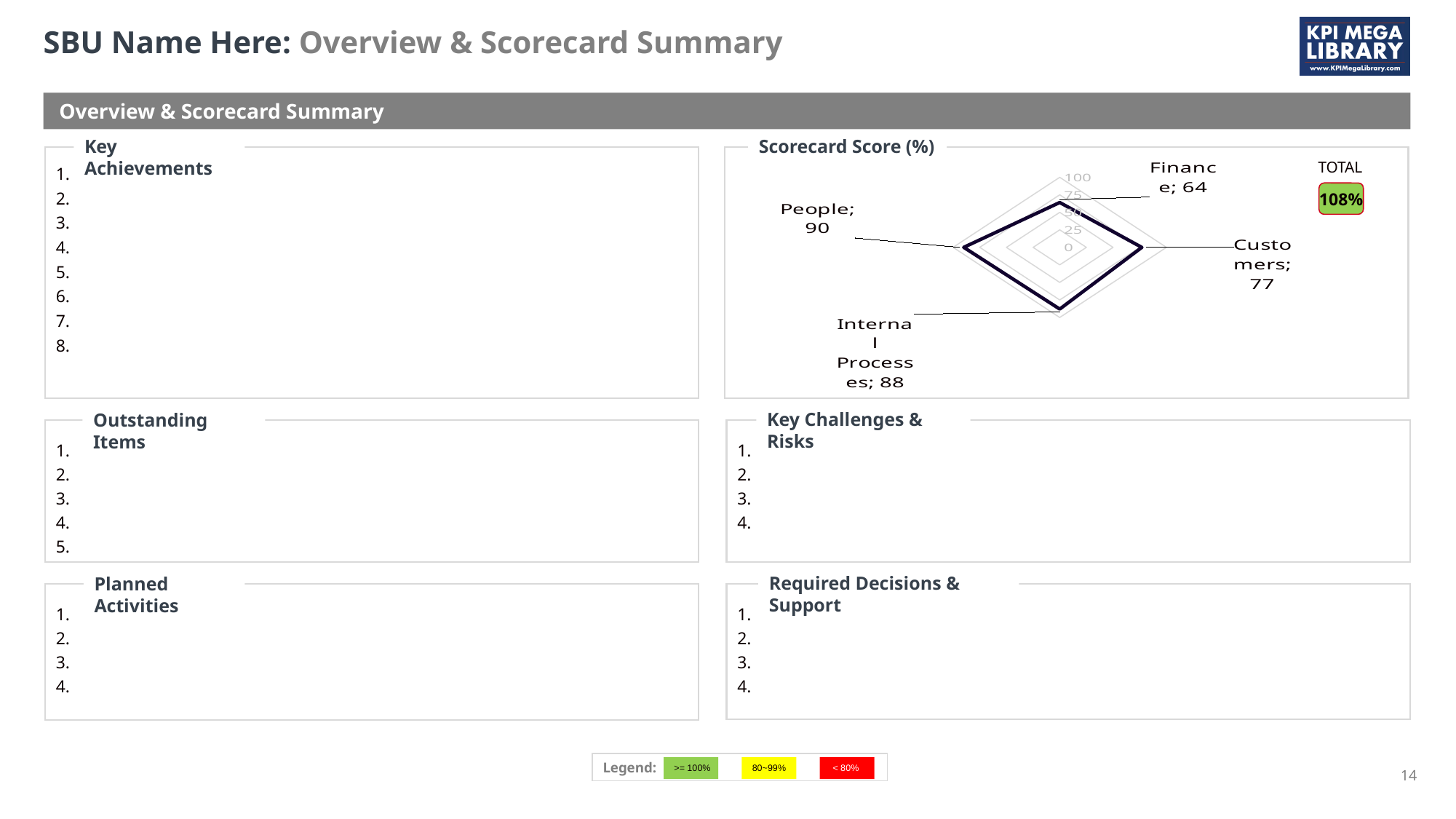
In the Scorecard Score (%) chart, what is the value for Customers? 77 In the Scorecard Score (%) chart, what is the value for Internal Processes? 88 In the Scorecard Score (%) chart, which category has the highest value? People In the Scorecard Score (%) chart, what is the difference between the People value and the Finance value? 26 What is the maximum value shown on the axis scale of the Scorecard Score (%) chart? 100 In the Scorecard Score (%) chart, which category has the lowest value? Finance What kind of chart is shown under "Scorecard Score (%)"? radar chart In the Scorecard Score (%) chart, what is the value for People? 90 In the Scorecard Score (%) chart, what is the value for Finance? 64 In the Scorecard Score (%) chart, which is larger, the value for Customers or the value for Internal Processes? Internal Processes In the Scorecard Score (%) chart, is the value for Finance greater or less than 75? less How many categories are plotted in the Scorecard Score (%) chart? 4